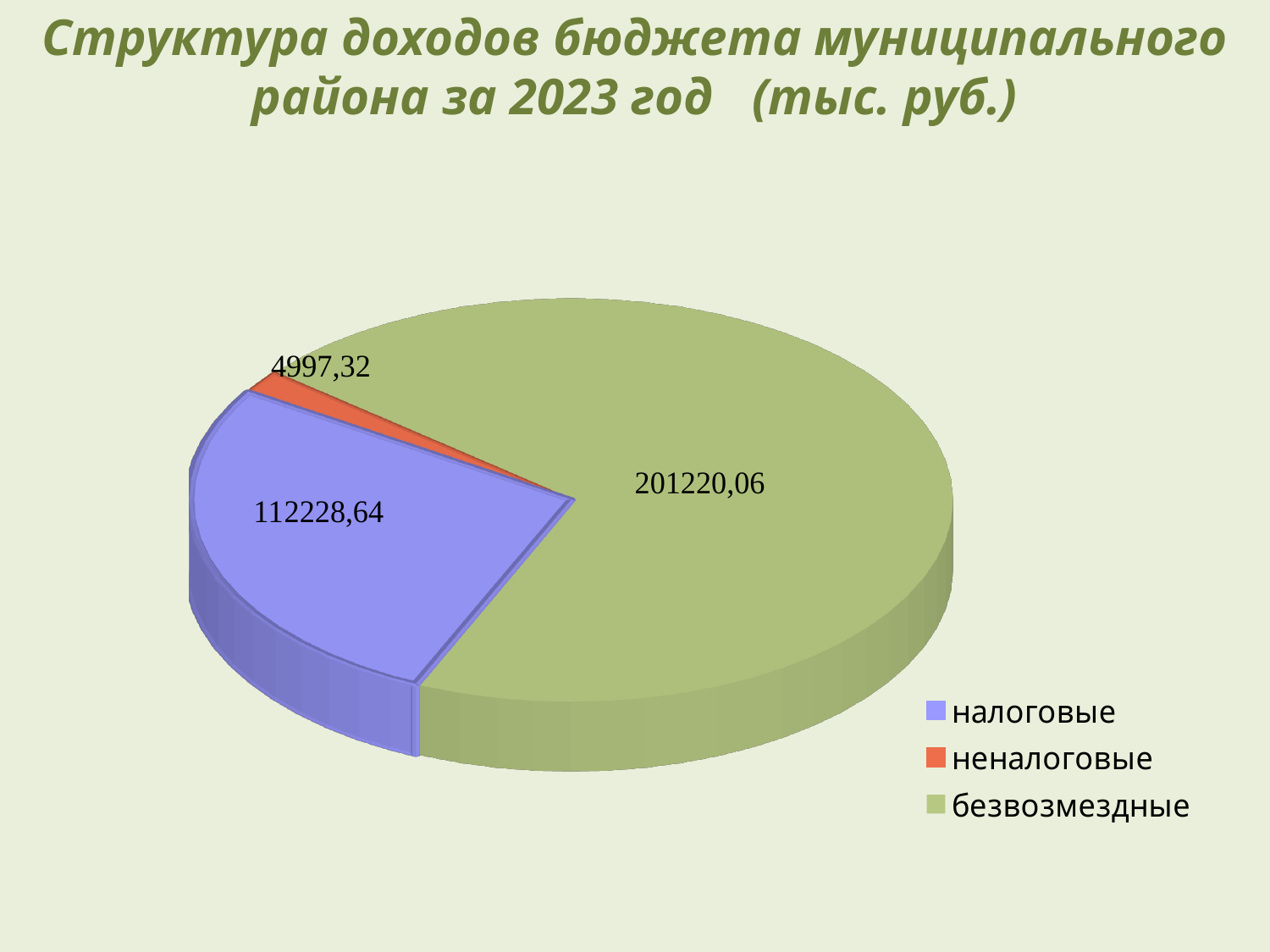
What is the difference between безвозмездные and налоговые? 88991,42 What is the value for безвозмездные? 201220,06 How many categories does the pie chart have? 3 Which category has the largest slice of the pie? безвозмездные What is the difference between налоговые and неналоговые? 107231,32 What unit of measurement is stated in the chart title? тыс. руб. What is the value for налоговые? 112228,64 Which is larger, налоговые or безвозмездные? безвозмездные What is the total of all slices in the pie chart? 318446,02 What type of chart is shown on the slide? Pie chart What is the value for неналоговые? 4997,32 Which category has the smallest slice of the pie? неналоговые